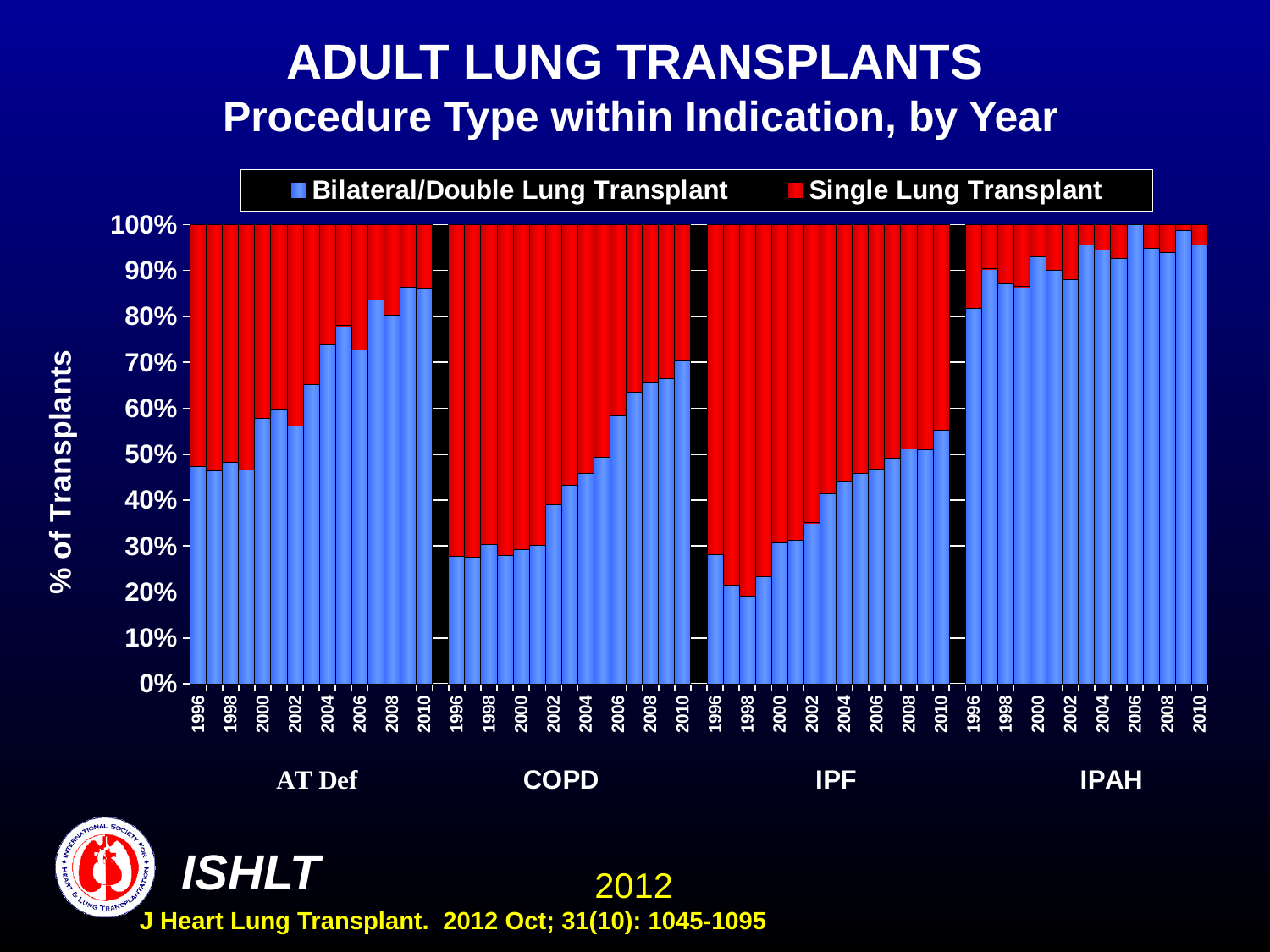
Which indication has the highest Bilateral/Double Lung Transplant share in 2010? IPAH In 1996, which has the larger Bilateral/Double Lung Transplant share, COPD or IPAH? IPAH How many series does the legend list? 2 What kind of chart is shown on the slide? Stacked bar chart Is the Bilateral/Double Lung Transplant share for COPD in 2010 greater or less than 60%? greater How many indication groups are shown along the x axis? 4 Which two procedure types are listed in the legend? Bilateral/Double Lung Transplant and Single Lung Transplant Is the Bilateral/Double Lung Transplant share for COPD in 1996 greater or less than 30%? less Does the Bilateral/Double Lung Transplant share for COPD rise or fall from 1996 to 2010? rise Is the Bilateral/Double Lung Transplant share for IPAH in 2010 greater or less than 90%? greater What is the label of the y axis? % of Transplants